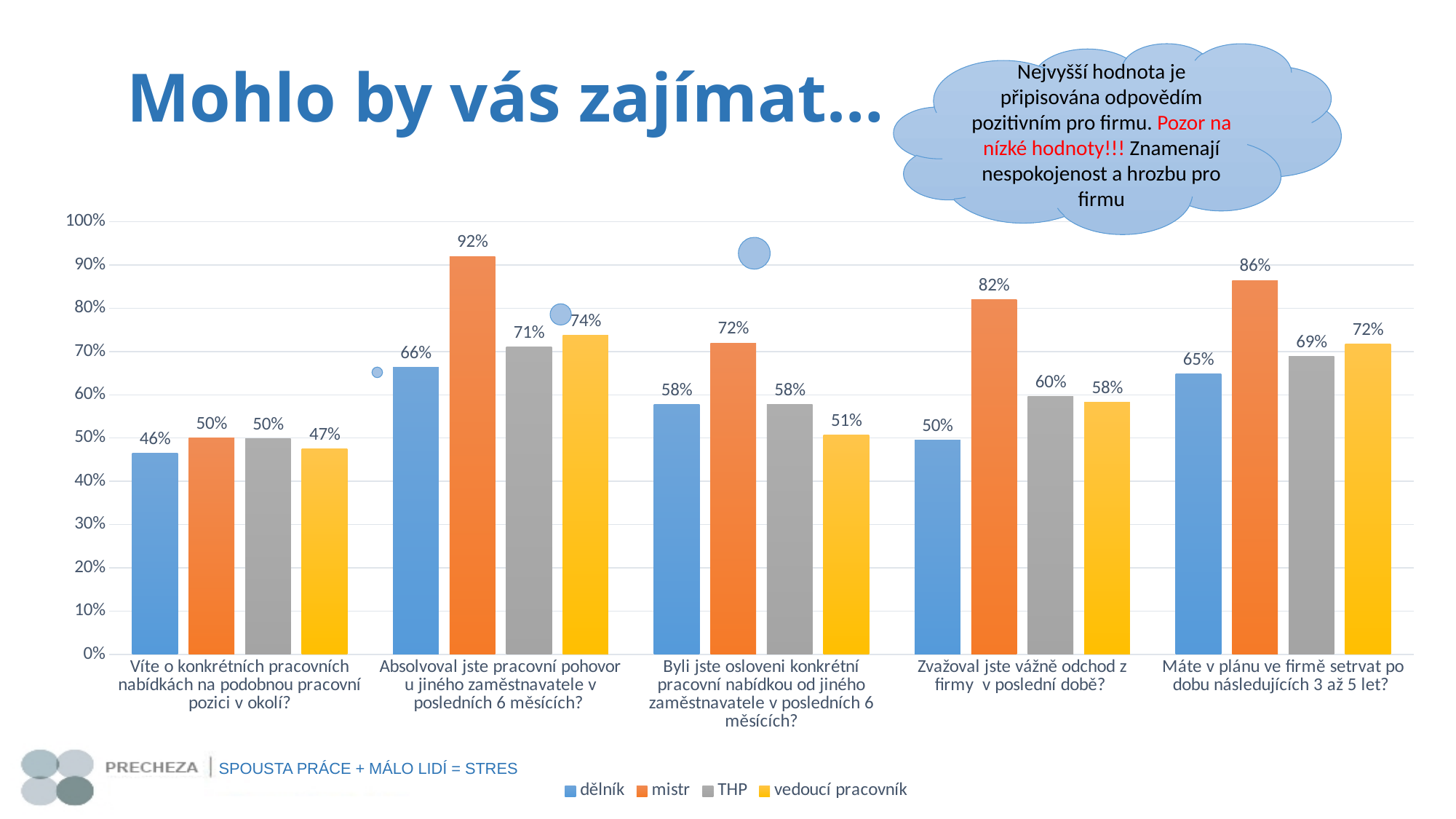
In the category "Máte v plánu ve firmě setrvat po dobu následujících 3 až 5 let?", which is larger: the THP value or the vedoucí pracovník value? vedoucí pracovník What is the value for vedoucí pracovník in the category "Máte v plánu ve firmě setrvat po dobu následujících 3 až 5 let?" 72% How many question categories are shown on the x axis? 5 What is the difference between the mistr and dělník values in the category "Absolvoval jste pracovní pohovor u jiného zaměstnavatele v posledních 6 měsících?" 26% Which colour represents the mistr series in the chart? orange Which series has the lowest value in the category "Byli jste osloveni konkrétní pracovní nabídkou od jiného zaměstnavatele v posledních 6 měsících?" vedoucí pracovník What is the value for mistr in the category "Absolvoval jste pracovní pohovor u jiného zaměstnavatele v posledních 6 měsících?" 92% What kind of chart is shown on the slide? bar chart What is the value for dělník in the category "Víte o konkrétních pracovních nabídkách na podobnou pracovní pozici v okolí?" 46% Which series has the highest value in the category "Zvažoval jste vážně odchod z firmy v poslední době?" mistr Is the value for mistr in the category "Máte v plánu ve firmě setrvat po dobu následujících 3 až 5 let?" greater or less than 80%? greater How many series does the legend list? 4